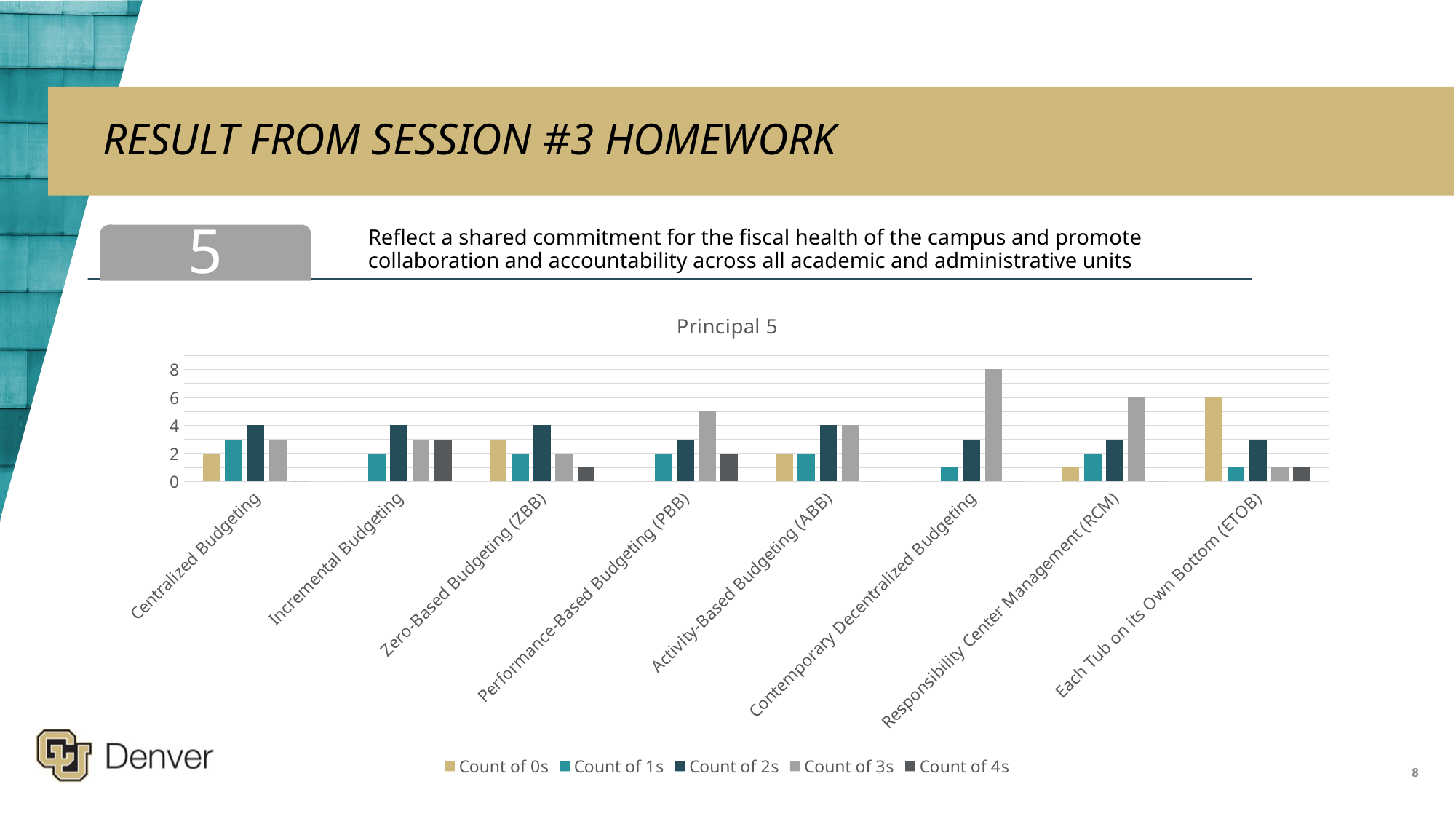
Which is larger: the Count of 3s for Responsibility Center Management (RCM) or the Count of 3s for Performance-Based Budgeting (PBB)? Responsibility Center Management (RCM) How many series does the legend of the chart list? 5 Which category has the highest Count of 3s? Contemporary Decentralized Budgeting Is the Count of 3s for Performance-Based Budgeting (PBB) greater or less than 4? greater What is the Count of 0s for Each Tub on its Own Bottom (ETOB)? 6 How many budgeting model categories are shown on the x axis of the chart? 8 Which category has the highest Count of 0s? Each Tub on its Own Bottom (ETOB) What is the Count of 3s for Responsibility Center Management (RCM)? 6 What is the Count of 3s for Contemporary Decentralized Budgeting? 8 What is the Count of 2s for Incremental Budgeting? 4 What kind of chart is shown on the slide? bar chart What is the difference between the Count of 3s for Contemporary Decentralized Budgeting and the Count of 3s for Responsibility Center Management (RCM)? 2